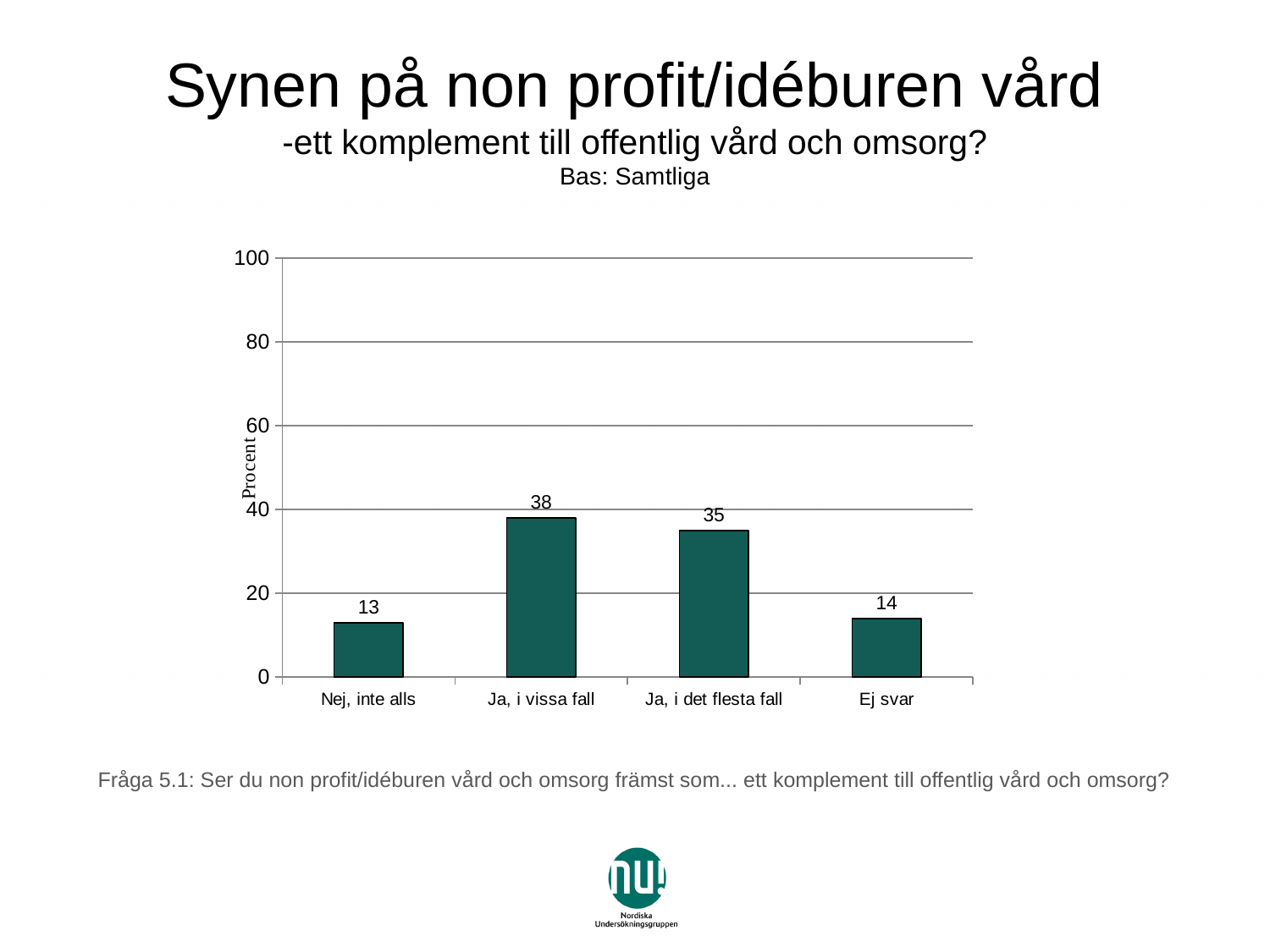
What is the value for "Ja, i vissa fall"? 38 What kind of chart is shown on the slide? bar chart Which category has the lowest value? Nej, inte alls What is the difference between the values for "Ja, i vissa fall" and "Ja, i det flesta fall"? 3 Is the value for "Ja, i vissa fall" greater or less than 20? greater What is the value for "Ja, i det flesta fall"? 35 Which is larger, the value for "Ja, i det flesta fall" or the value for "Ej svar"? Ja, i det flesta fall How many categories are shown on the x axis? 4 What is the value for "Nej, inte alls"? 13 Which category has the highest value? Ja, i vissa fall What is the value for "Ej svar"? 14 What is the label of the y axis? Procent